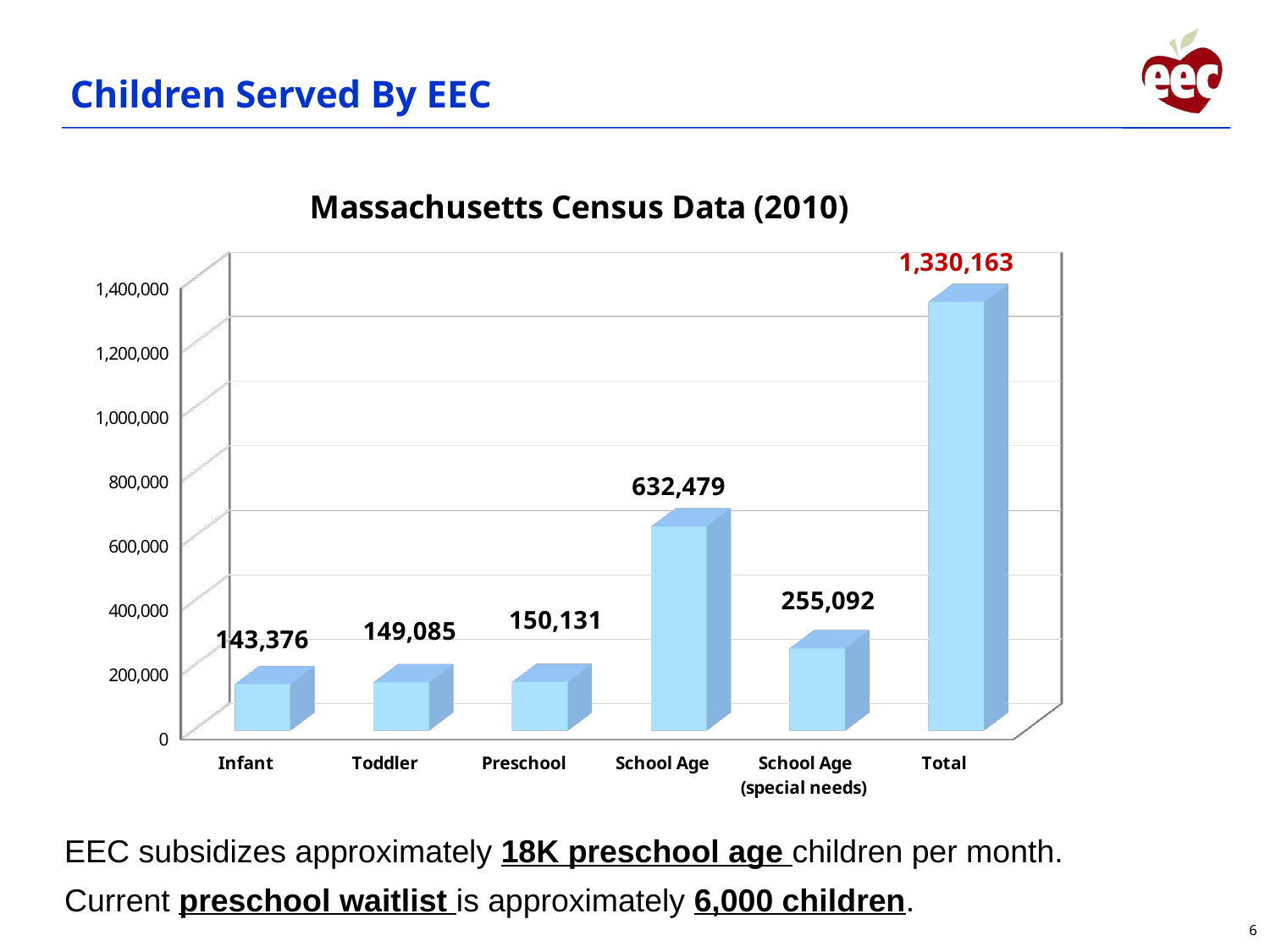
What is the value for School Age? 632,479 What is the value for School Age (special needs)? 255,092 What is the title of the chart? Massachusetts Census Data (2010) What is the difference between the Preschool value and the Toddler value? 1,046 What is the value for Infant? 143,376 Which category has the lowest value? Infant How many categories are shown on the x axis? 6 What is the value for Total? 1,330,163 What kind of chart is shown? Bar chart What is the difference between the School Age value and the School Age (special needs) value? 377,387 Excluding the Total bar, which category has the highest value? School Age Which is larger, the value for Toddler or the value for Preschool? Preschool